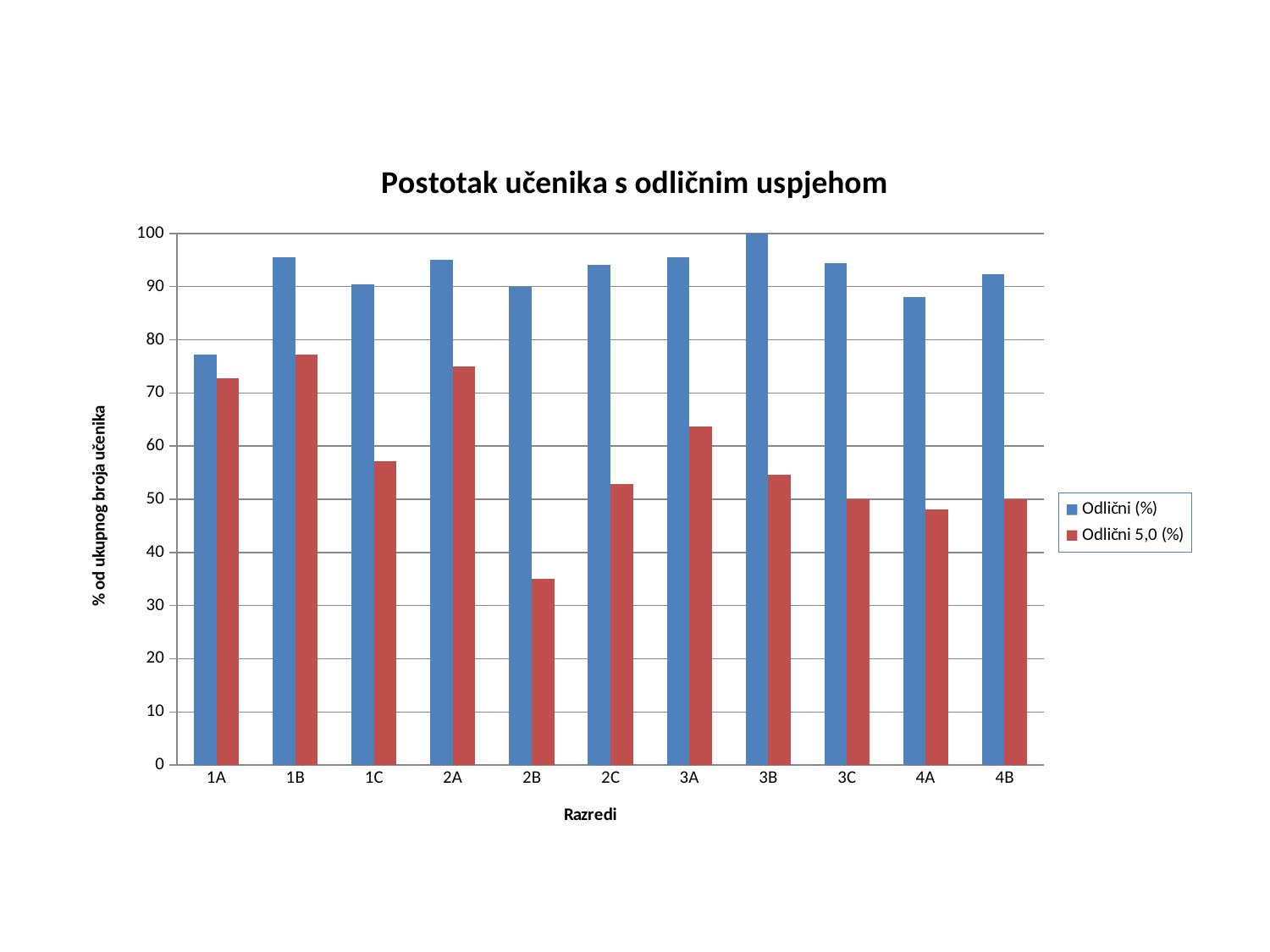
What is the Odlični (%) value for class 3B? 100 Which class has the lowest Odlični 5,0 (%) value? 2B What is the Odlični 5,0 (%) value for class 3C? 50 What is the title of the chart? Postotak učenika s odličnim uspjehom What type of chart is shown on the slide? bar chart Is the Odlični 5,0 (%) value for class 2B greater or less than 40? less Which class has the highest Odlični (%) value? 3B Is the Odlični 5,0 (%) value for class 3A greater or less than 60? greater How many classes (categories) are shown on the x axis? 11 Which class has the lowest Odlični (%) value? 1A Which is larger, the Odlični 5,0 (%) value for class 2B or for class 2C? 2C How many series does the legend list? 2